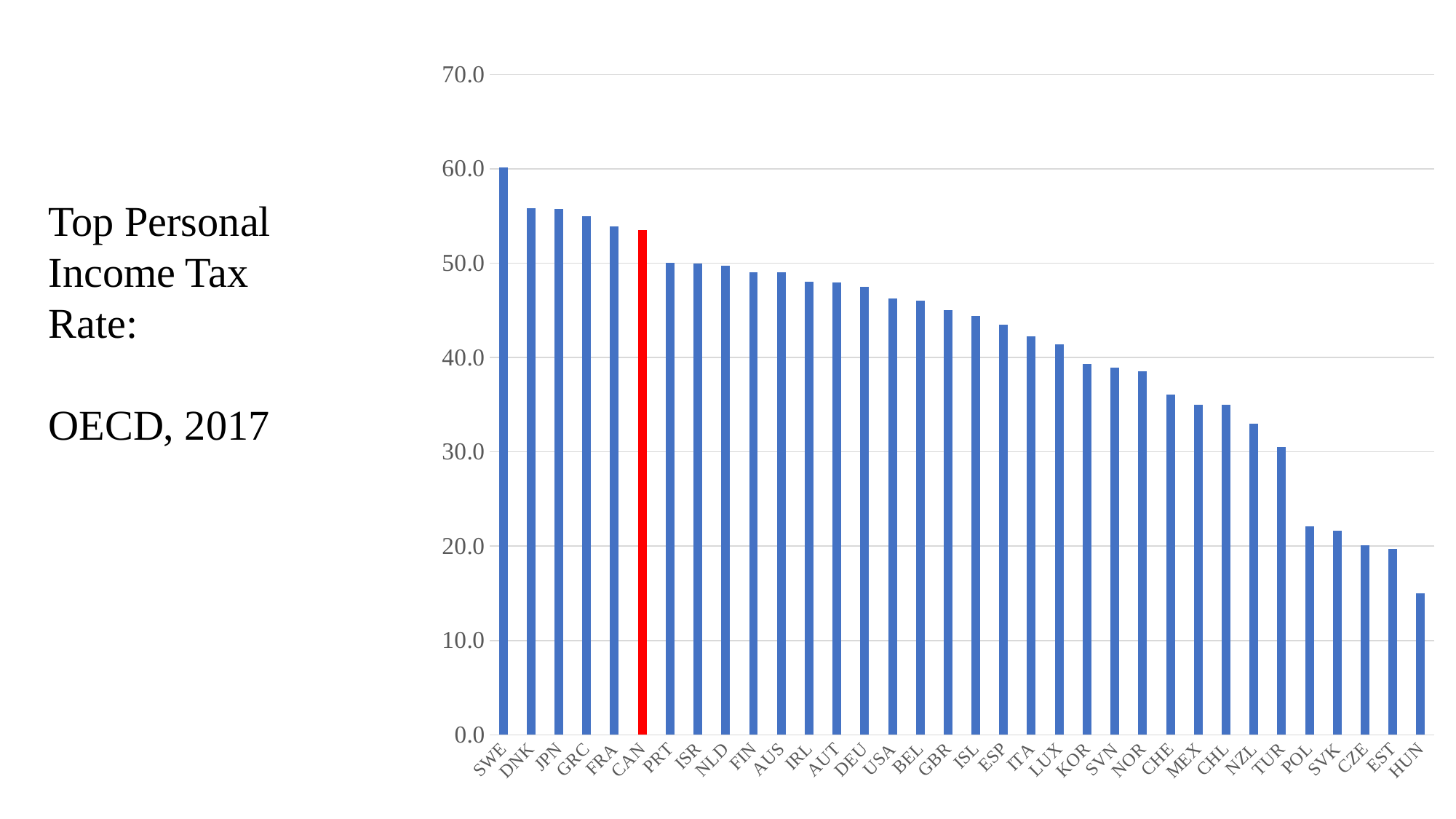
How many countries are shown on the x axis of the chart? 34 Is the value for HUN greater or less than 20? less Is the value for CAN greater or less than 50? greater Which country's bar is coloured red in the chart? CAN Which country has the highest top personal income tax rate in the chart? SWE What kind of chart is shown on the slide? bar chart Which has the larger value, SWE or DNK? SWE Is the value for CHE greater or less than 30? greater Do the values rise or fall moving from left to right along the x axis? fall Which country has the lowest top personal income tax rate in the chart? HUN